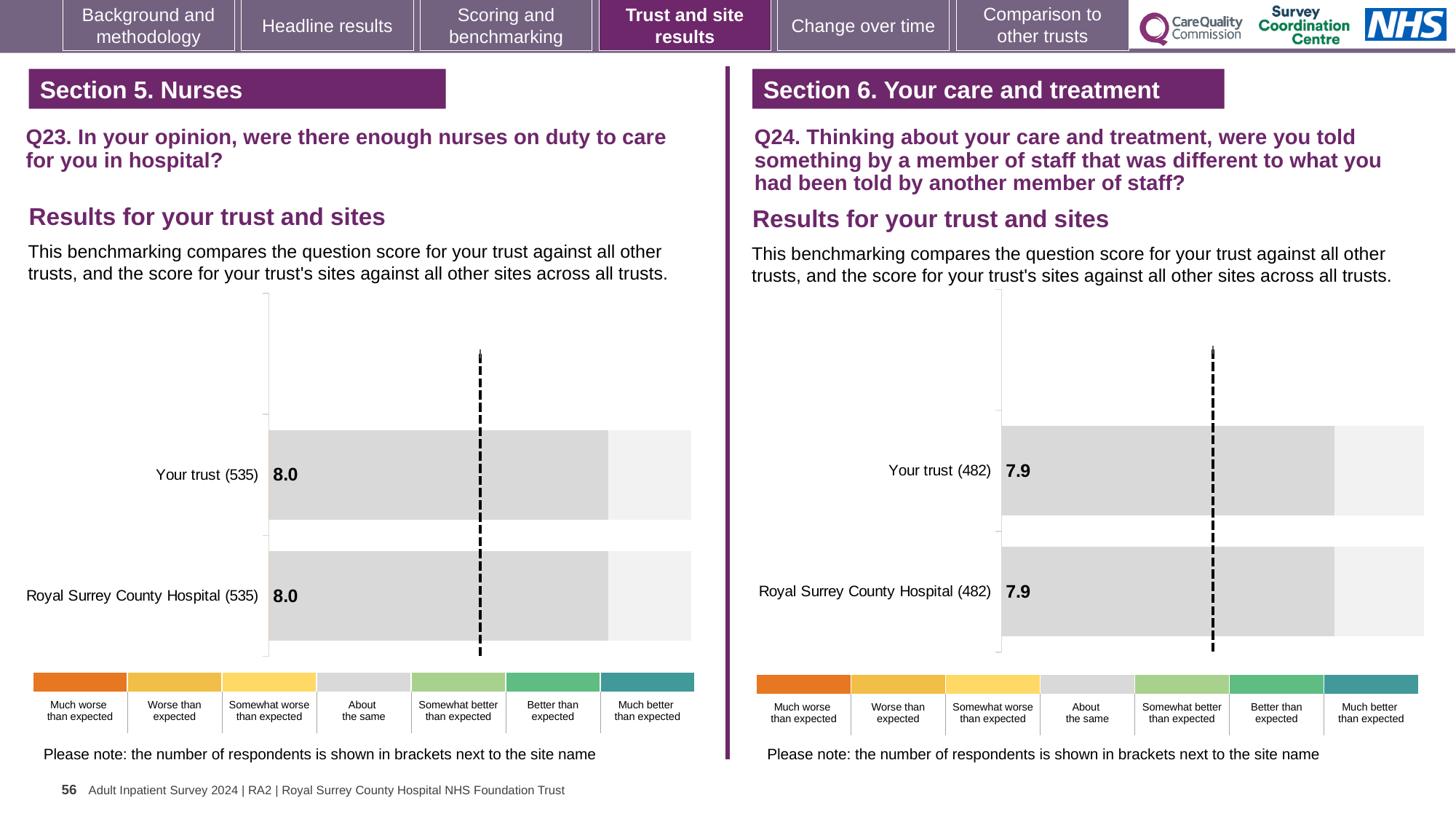
On the Q24 chart (right), how many bars are plotted? 2 On the Q23 chart (left), how many respondents are shown in brackets next to Your trust? 535 On the Q24 chart (right), what is the difference between the score for Your trust and the score for Royal Surrey County Hospital? 0.0 On the Q24 chart (right), what is the score for Your trust? 7.9 What kind of chart is the Q23 chart on the left? Bar chart On the Q23 chart (left), what is the score for Royal Surrey County Hospital? 8.0 On the Q23 chart (left), what is the score for Your trust? 8.0 On the Q23 chart (left), how many bars are plotted? 2 On the Q24 chart (right), what is the score for Royal Surrey County Hospital? 7.9 On the Q24 chart (right), how many respondents are shown in brackets next to Royal Surrey County Hospital? 482 On the Q24 chart (right), how many categories does the colour legend below the chart list? 7 On the Q23 chart (left), what is the difference between the score for Your trust and the score for Royal Surrey County Hospital? 0.0